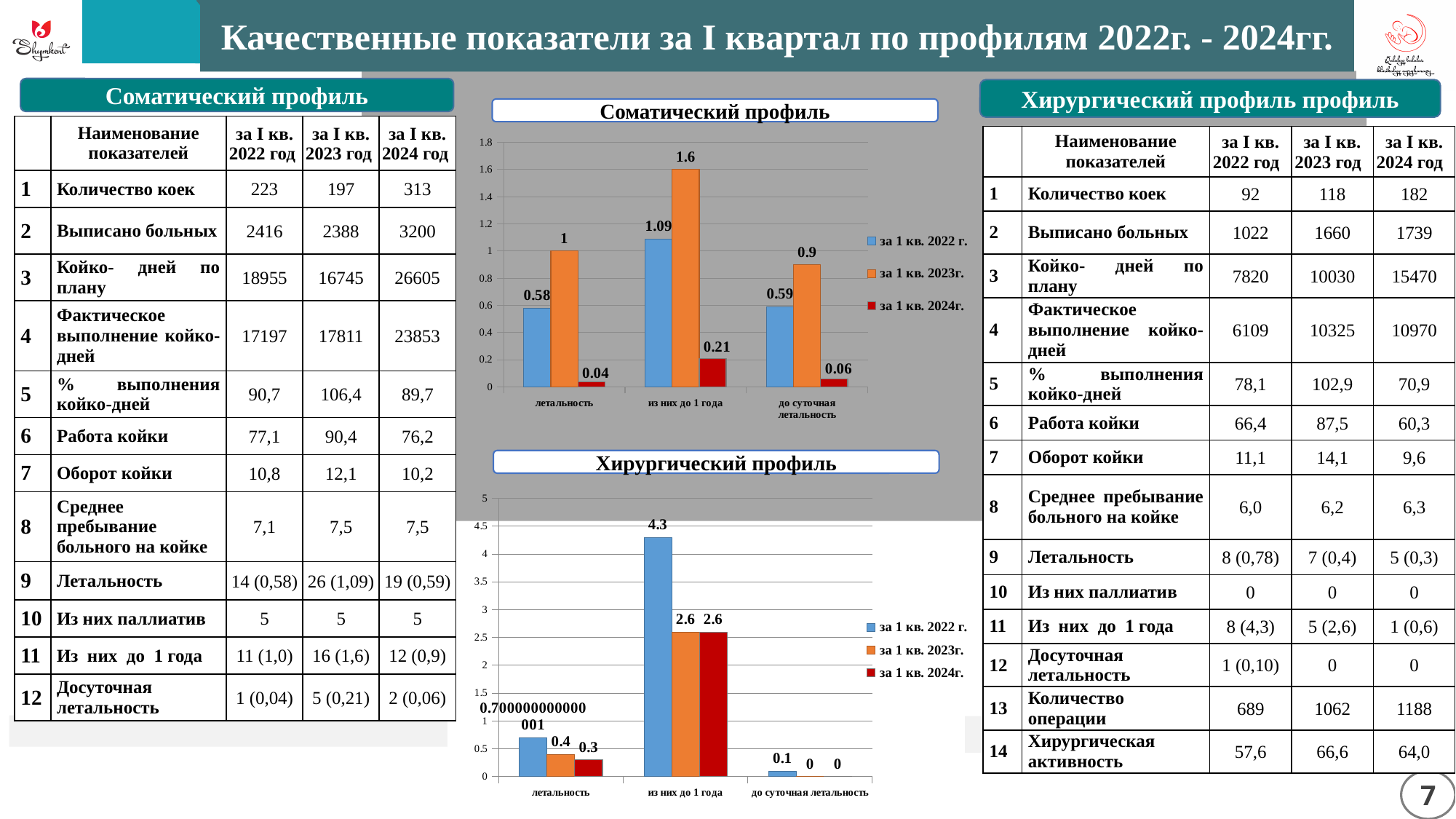
In the 'Хирургический профиль' chart, what is the value for 'летальность' in the series 'за 1 кв. 2024г.'? 0.3 In the 'Хирургический профиль' chart, which series has the lowest value for 'летальность'? за 1 кв. 2024г. In the 'Хирургический профиль' chart, what is the value for 'из них до 1 года' in the series 'за 1 кв. 2022 г.'? 4.3 In the 'Соматический профиль' chart, which is larger: the 'за 1 кв. 2022 г.' value for 'летальность' or the 'за 1 кв. 2023г.' value for 'летальность'? за 1 кв. 2023г. In the 'Хирургический профиль' chart, is the 'за 1 кв. 2022 г.' value for 'из них до 1 года' greater or less than 4? greater In the 'Хирургический профиль' chart, how many categories are shown on the x axis? 3 In the 'Соматический профиль' chart, what is the difference between the 'за 1 кв. 2023г.' and 'за 1 кв. 2022 г.' values for 'до суточная летальность'? 0.31 In the 'Соматический профиль' chart, how many series does the legend list? 3 In the 'Соматический профиль' chart, what is the value for 'из них до 1 года' in the series 'за 1 кв. 2023г.'? 1.6 In the 'Соматический профиль' chart, what is the value for 'летальность' in the series 'за 1 кв. 2024г.'? 0.04 What kind of chart is the 'Хирургический профиль' chart? bar chart In the 'Соматический профиль' chart, which category has the highest value for the series 'за 1 кв. 2022 г.'? из них до 1 года